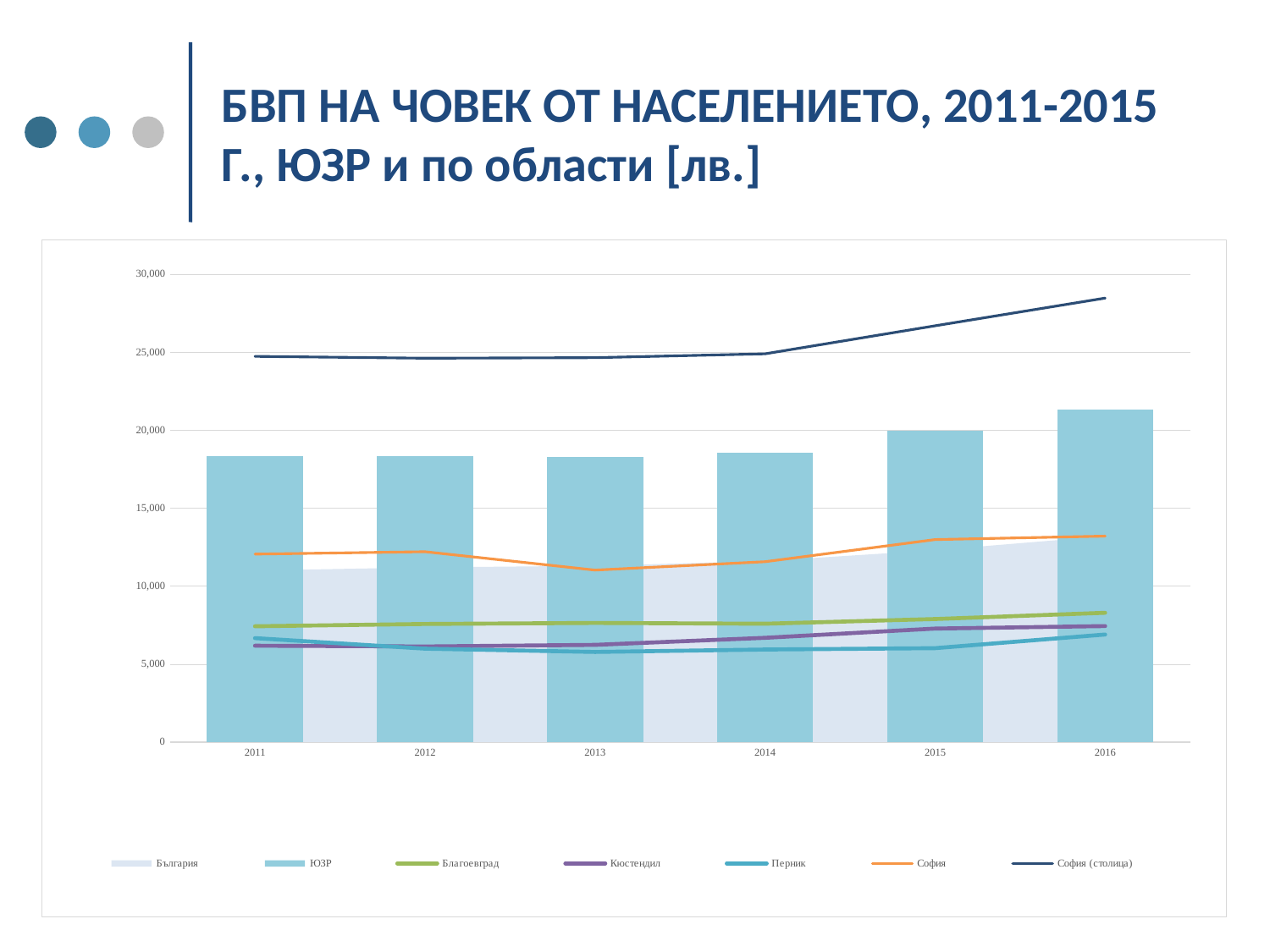
Is the value for ЮЗР in 2016 greater or less than 20,000? greater Which series has the lowest value in 2016? Перник Which is larger in 2011, the value for София or the value for Благоевград? София Is the value for София (столица) in 2016 greater or less than 25,000? greater In which year is the ЮЗР bar the tallest? 2016 Which series is drawn as bars? ЮЗР Which series has the highest values across all years? София (столица) Is the value for Перник in 2013 greater or less than 10,000? less Does the value for София (столица) rise or fall from 2014 to 2016? rise How many years are shown on the x axis? 6 How many series does the legend list? 7